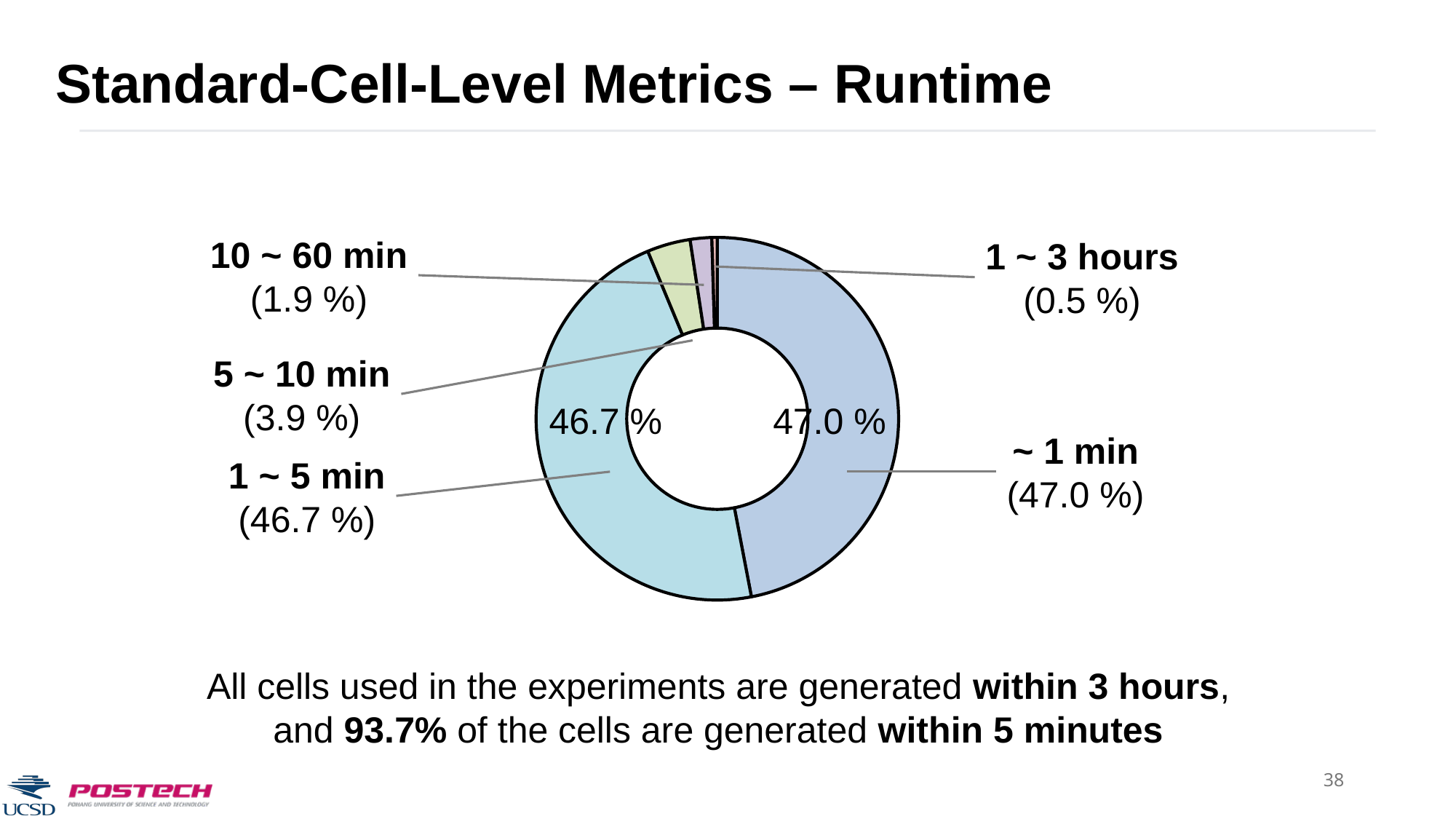
What kind of chart is shown on the slide? doughnut chart Which runtime category has the largest share of the chart? ~ 1 min Which runtime category has the smallest share of the chart? 1 ~ 3 hours What share of cells have a runtime of ~ 1 min? 47.0 % What percentage is shown for the 1 ~ 5 min category? 46.7 % What percentage is shown for the 10 ~ 60 min category? 1.9 % What percentage of cells take 1 ~ 3 hours? 0.5 % What is the difference between the 5 ~ 10 min share and the 10 ~ 60 min share? 2.0 % Which category has a larger share: 5 ~ 10 min or 10 ~ 60 min? 5 ~ 10 min What percentage of cells fall in the 5 ~ 10 min category? 3.9 % How many runtime categories are shown in the chart? 5 What is the difference in percentage points between the ~ 1 min and 1 ~ 5 min categories? 0.3 %